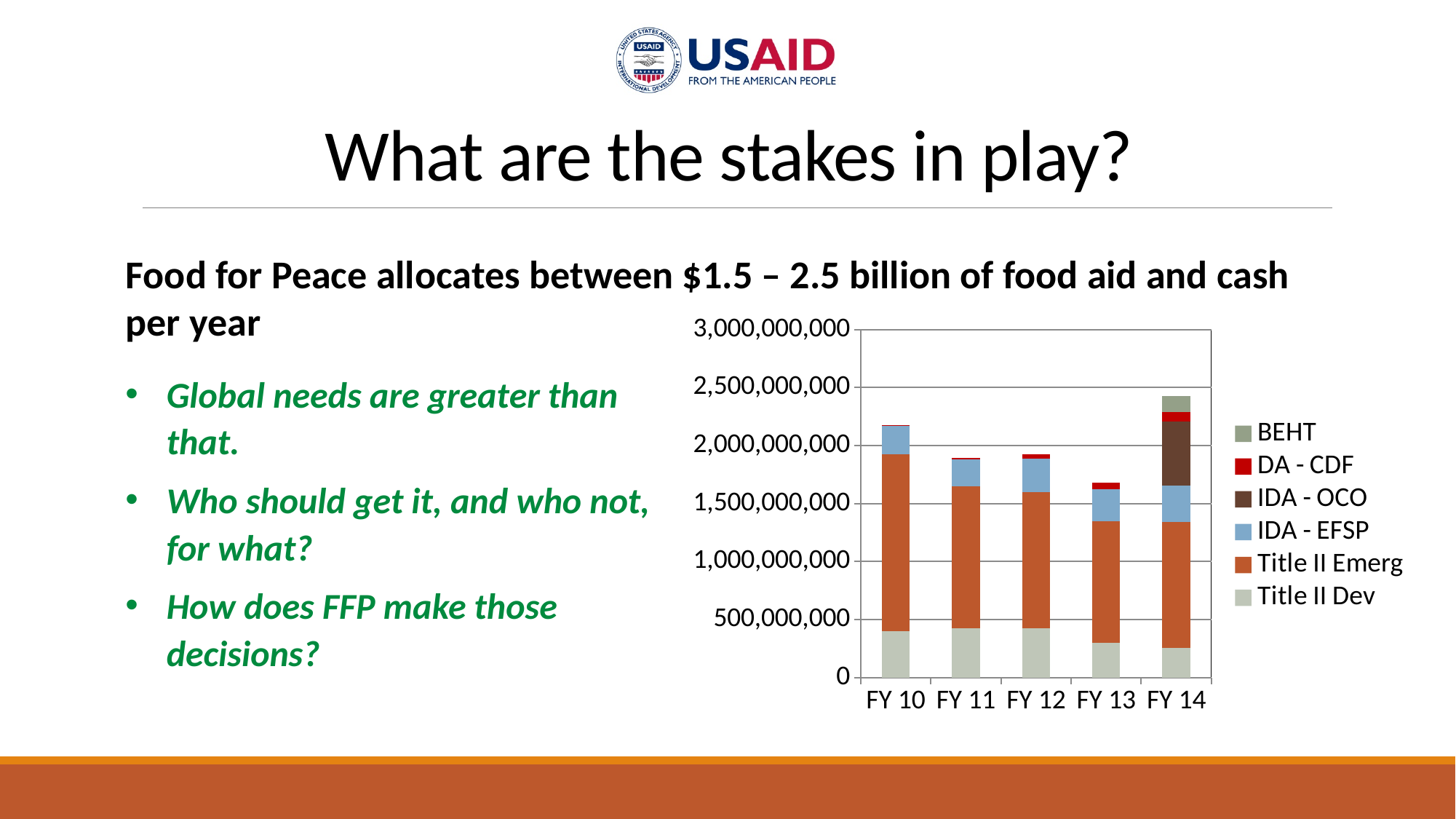
Is the total bar for FY 10 greater or less than 2,000,000,000? greater Which fiscal year has the highest total bar in the chart? FY 14 What kind of chart is shown on the slide? Stacked bar chart Does the total bar rise or fall from FY 13 to FY 14? Rises Is the total bar for FY 14 greater or less than 2,000,000,000? greater Which fiscal year has the lowest total bar in the chart? FY 13 Which is larger, the total bar for FY 14 or the total bar for FY 13? FY 14 How many fiscal years are shown on the x axis of the chart? 5 Which series is listed at the bottom of the chart's legend? Title II Dev Is the total bar for FY 13 greater or less than 2,000,000,000? less How many series does the chart's legend list? 6 Which series in the chart is shown in dark brown? IDA - OCO